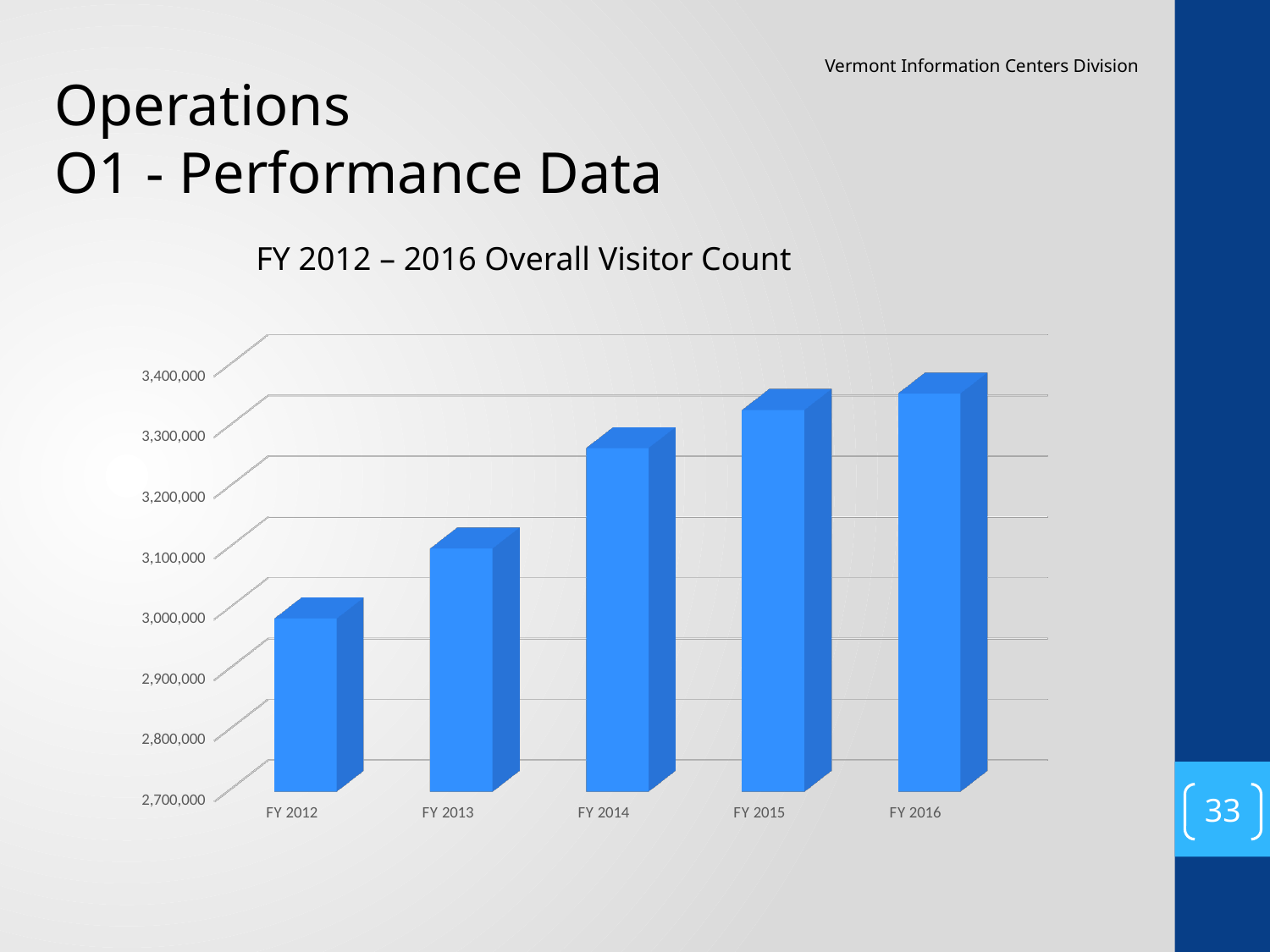
Which fiscal year has the lowest overall visitor count? FY 2012 Do the visitor counts rise or fall from FY 2012 to FY 2016? rise Is the value for FY 2015 greater or less than 3,300,000? greater Is the value for FY 2013 greater or less than 3,000,000? greater What is the title of the chart? FY 2012 – 2016 Overall Visitor Count What kind of chart is shown on the slide? bar chart Which is larger, the visitor count for FY 2013 or for FY 2014? FY 2014 How many fiscal years are shown on the x axis of the chart? 5 Is the value for FY 2014 greater or less than 3,200,000? greater Which fiscal year has the highest overall visitor count? FY 2016